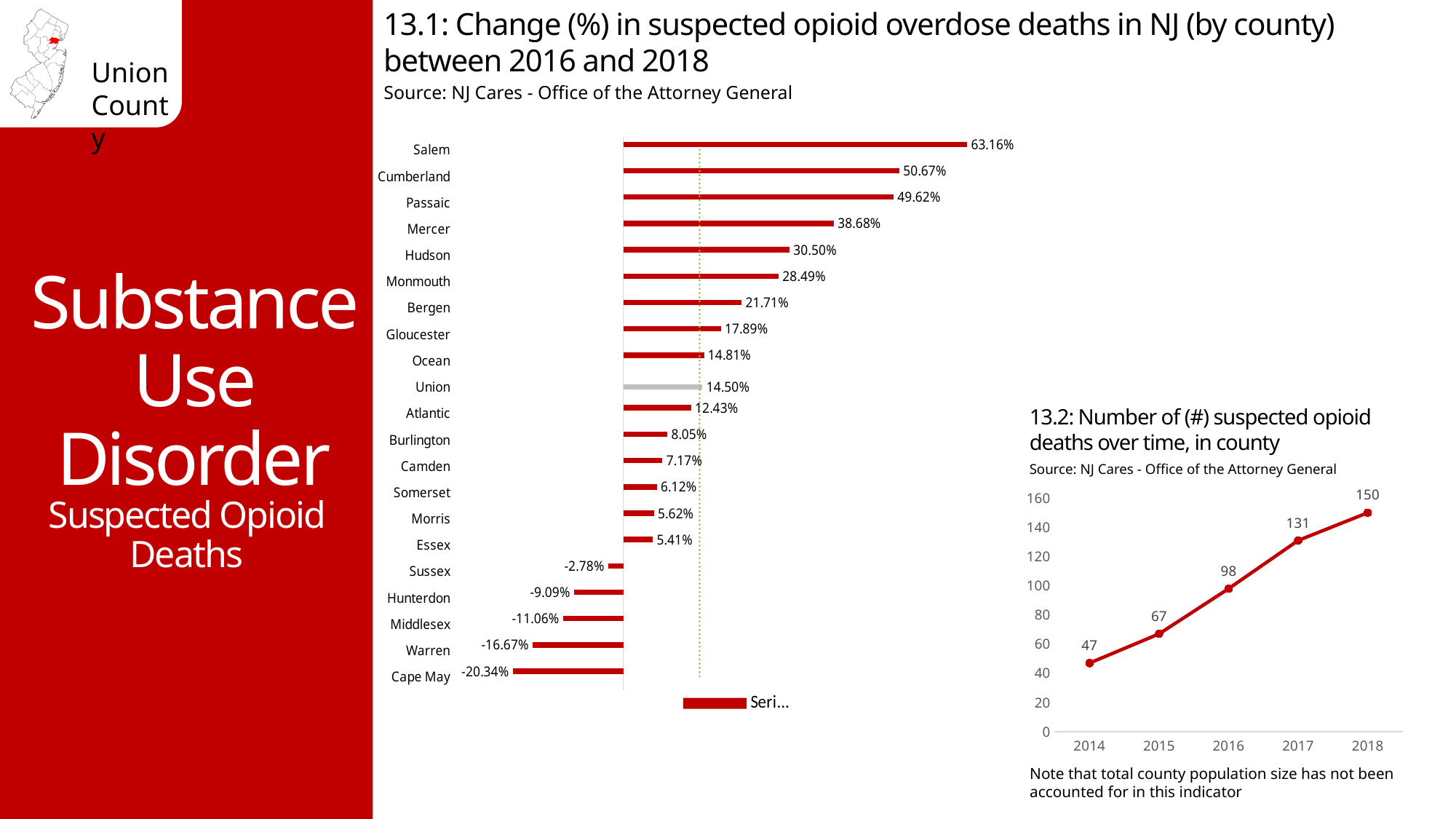
In chart 13.1, which county has the lowest change (%) in suspected opioid overdose deaths? Cape May In chart 13.2, do suspected opioid deaths rise or fall from 2014 to 2018? Rise What kind of chart is chart 13.2? Line chart In chart 13.1, which county has a larger change (%): Passaic or Mercer? Passaic In chart 13.1, which county has the highest change (%) in suspected opioid overdose deaths? Salem What kind of chart is chart 13.1? Bar chart In chart 13.2, what is the difference in suspected opioid deaths between 2018 and 2014? 103 In chart 13.1, how many counties are shown? 21 In chart 13.1, what is the change (%) in suspected opioid overdose deaths for Union county? 14.50% In chart 13.2, how many suspected opioid deaths were there in 2016? 98 In chart 13.1, what is the difference in percentage points between Salem and Cumberland? 12.49 In chart 13.1, what is the change (%) for Hudson? 30.50%